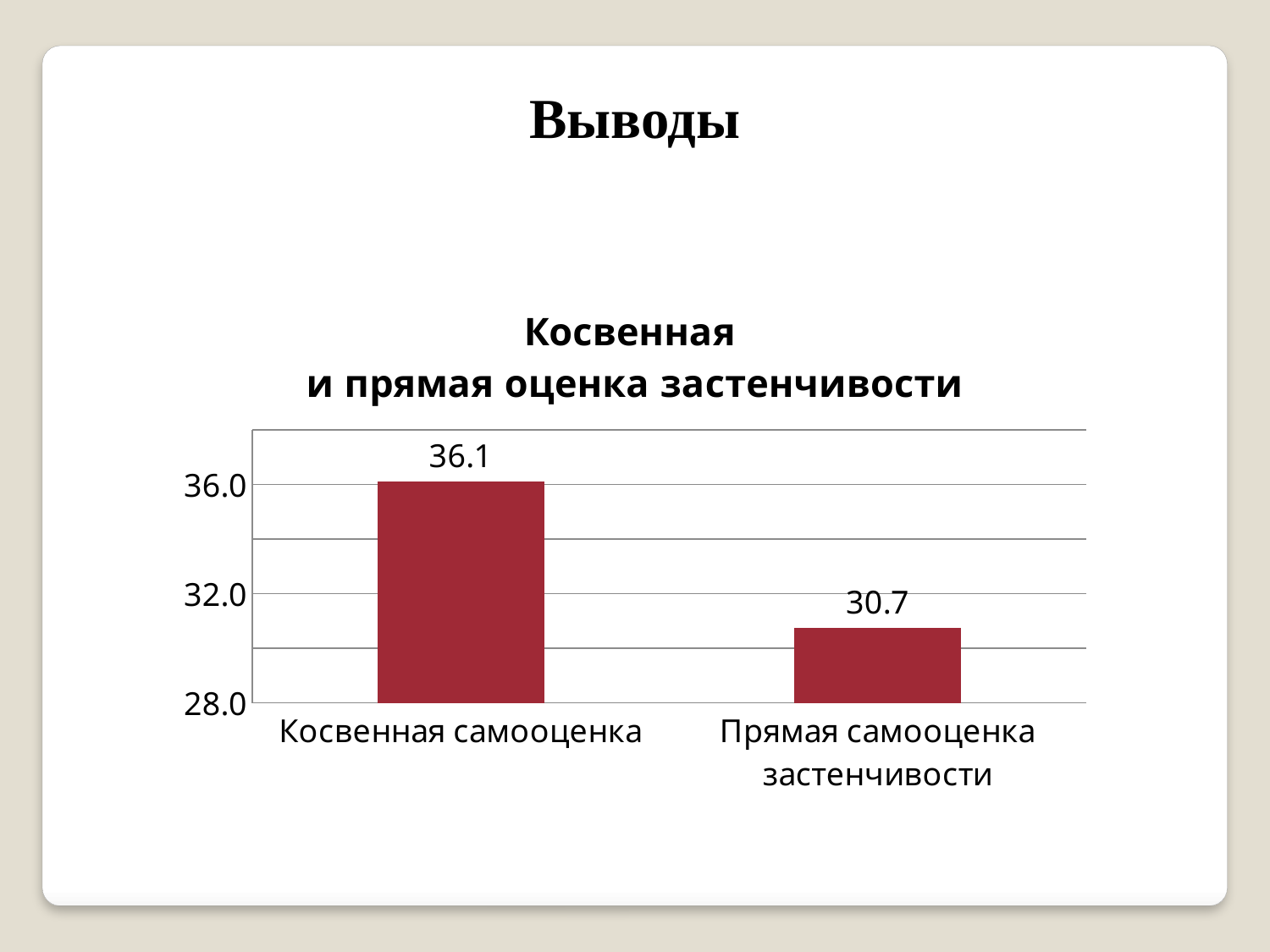
Which category has the lowest value? Прямая самооценка застенчивости Is the value for Косвенная самооценка greater or less than 32.0? greater How many categories are shown in the chart? 2 What is the lowest value shown on the vertical axis? 28.0 Which is larger: the value for Косвенная самооценка or the value for Прямая самооценка застенчивости? Косвенная самооценка Which category has the highest value? Косвенная самооценка What kind of chart is shown on the slide? bar chart What is the title of the chart? Косвенная и прямая оценка застенчивости Is the value for Прямая самооценка застенчивости greater or less than 32.0? less What is the value for Косвенная самооценка? 36.1 What is the value for Прямая самооценка застенчивости? 30.7 What is the difference between the values for Косвенная самооценка and Прямая самооценка застенчивости? 5.4